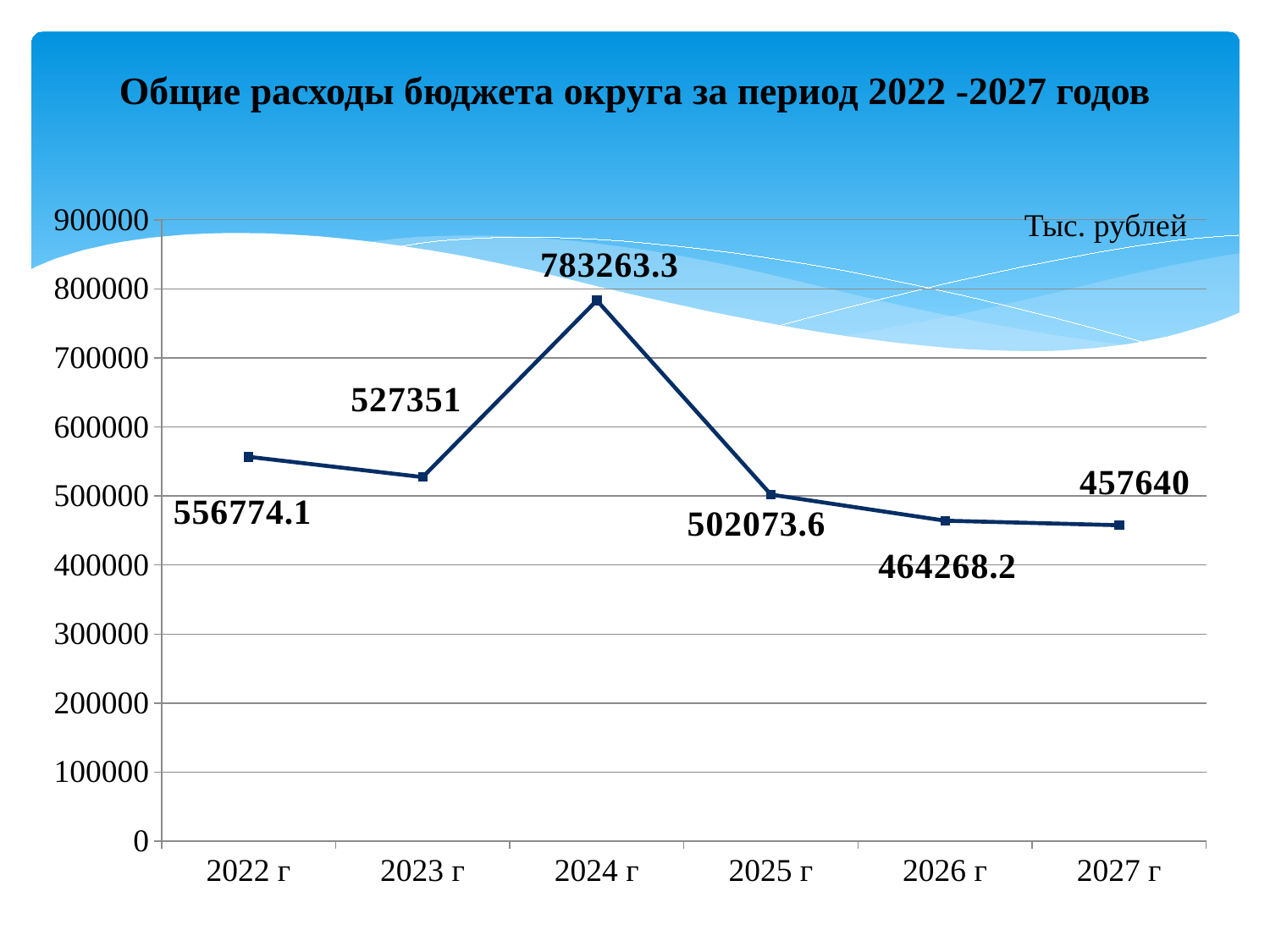
What is the difference between the values for 2022 г and 2027 г? 99134.1 Which year has the highest value? 2024 г Which is larger, the value for 2022 г or the value for 2025 г? 2022 г What is the value for 2027 г? 457640 Which year has the lowest value? 2027 г Do the values rise or fall from 2024 г to 2027 г? fall What is the value for 2024 г? 783263.3 How many years are plotted on the chart? 6 What is the difference between the values for 2024 г and 2023 г? 255912.3 What is the value for 2022 г? 556774.1 Is the value for 2026 г greater or less than 500000? less What kind of chart is shown on the slide? line chart